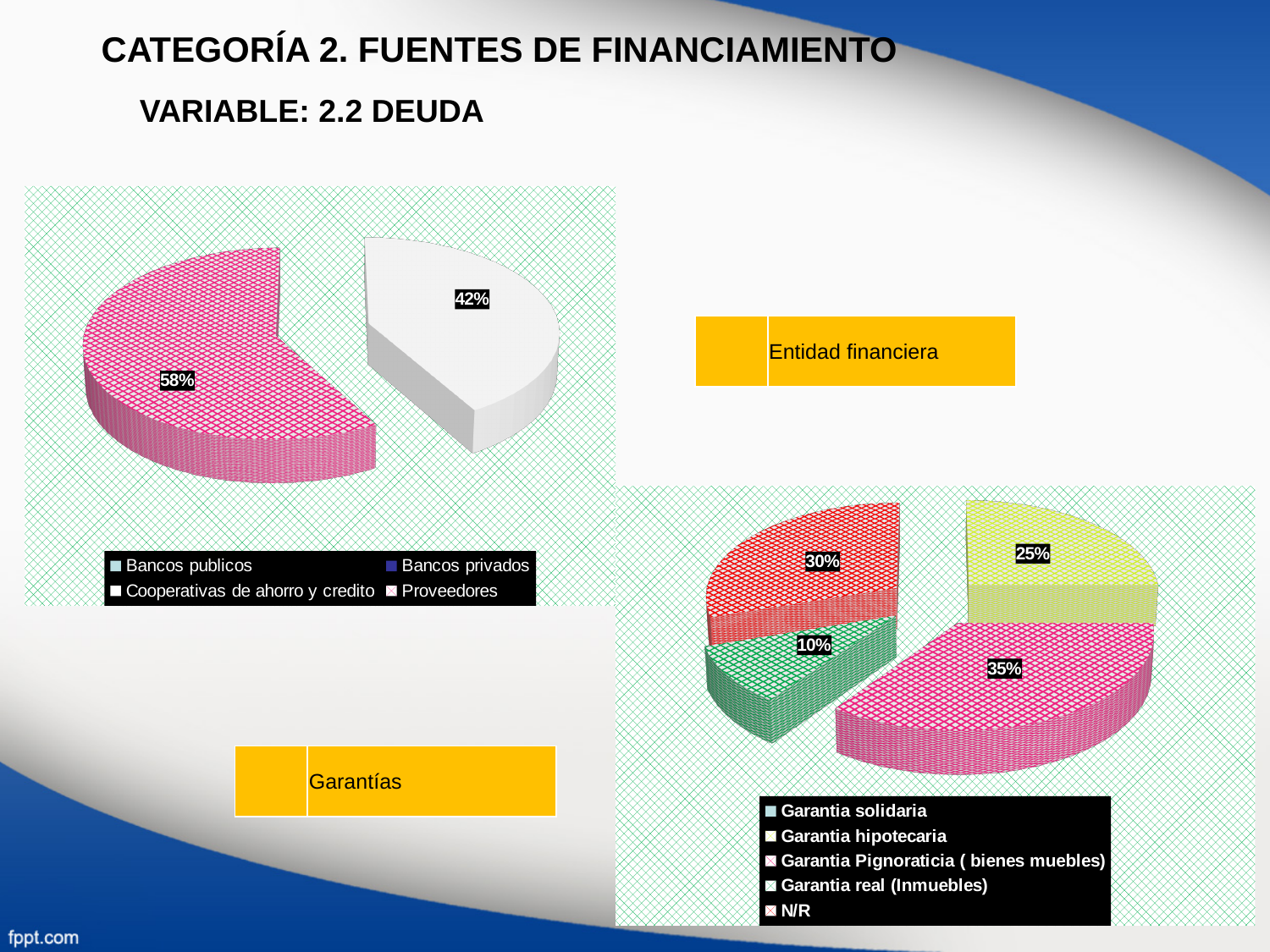
In the Entidad financiera chart, what is the value of the largest slice? 58% In the Entidad financiera chart, what is the value of the smallest slice? 42% In the Garantías chart, what is the value of the largest slice? 35% How many slices does the Entidad financiera pie chart have? 2 In the Garantías chart, what is the difference between the largest and smallest slices? 25% In the Garantías chart, which is larger: the red slice or the yellow slice? the red slice (30%) In the Entidad financiera chart, what is the difference between the two slices? 16% What kind of chart is the Entidad financiera chart? pie chart How many entries does the legend of the Garantías chart list? 5 How many entries does the legend of the Entidad financiera chart list? 4 How many slices does the Garantías pie chart have? 4 In the Garantías chart, what is the value of the smallest slice? 10%